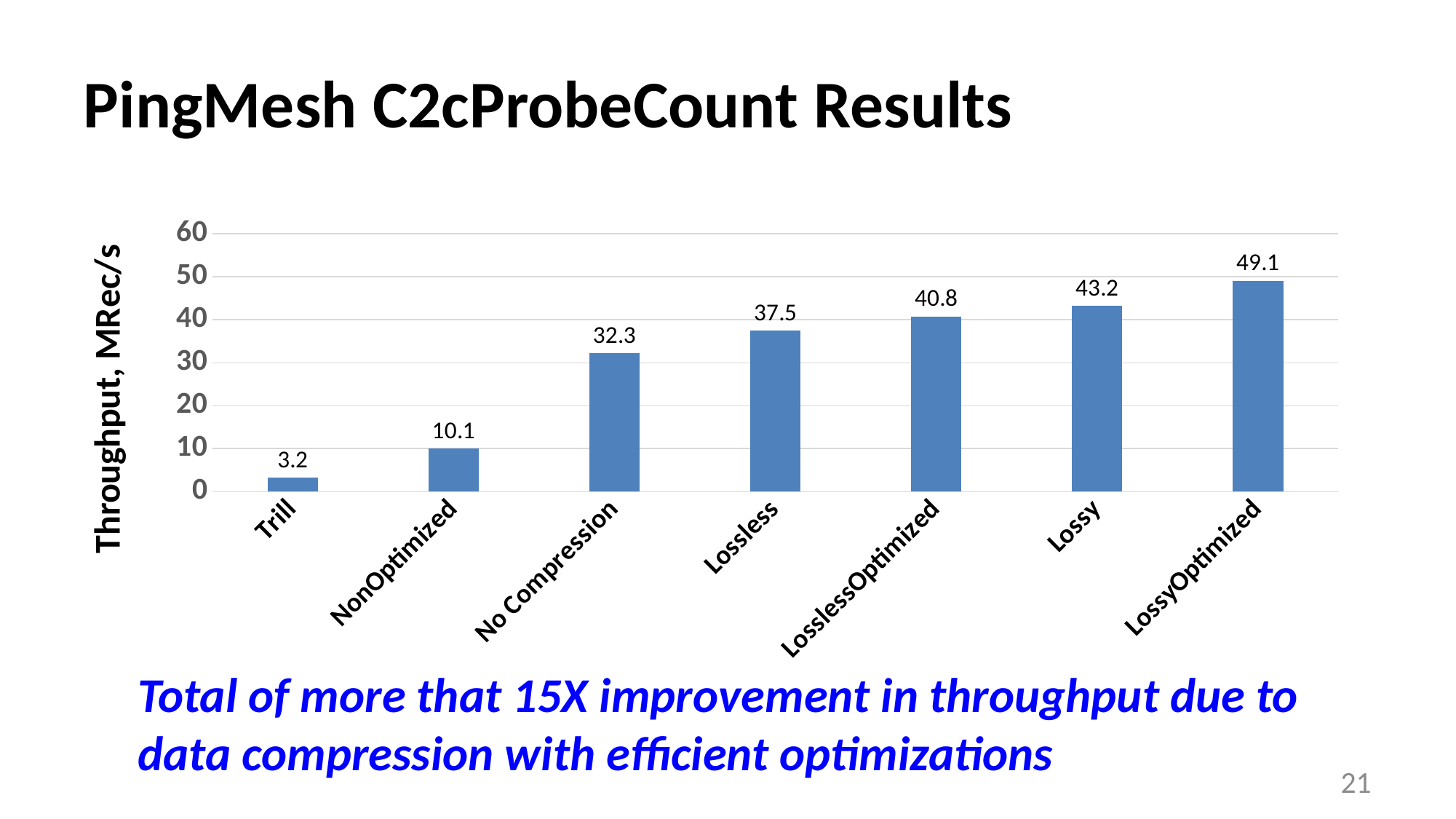
What kind of chart is shown on the slide? Bar chart What is the difference in throughput between LossyOptimized and Trill? 45.9 How many categories are shown on the x axis? 7 Which has a higher throughput, NonOptimized or No Compression? No Compression What is the throughput for LossyOptimized? 49.1 What is the label of the y axis? Throughput, MRec/s What is the difference in throughput between Lossy and Lossless? 5.7 Is the throughput for LosslessOptimized greater or less than 40? greater Which category has the highest throughput? LossyOptimized Which category has the lowest throughput? Trill What is the throughput for Trill? 3.2 What is the throughput for Lossless? 37.5